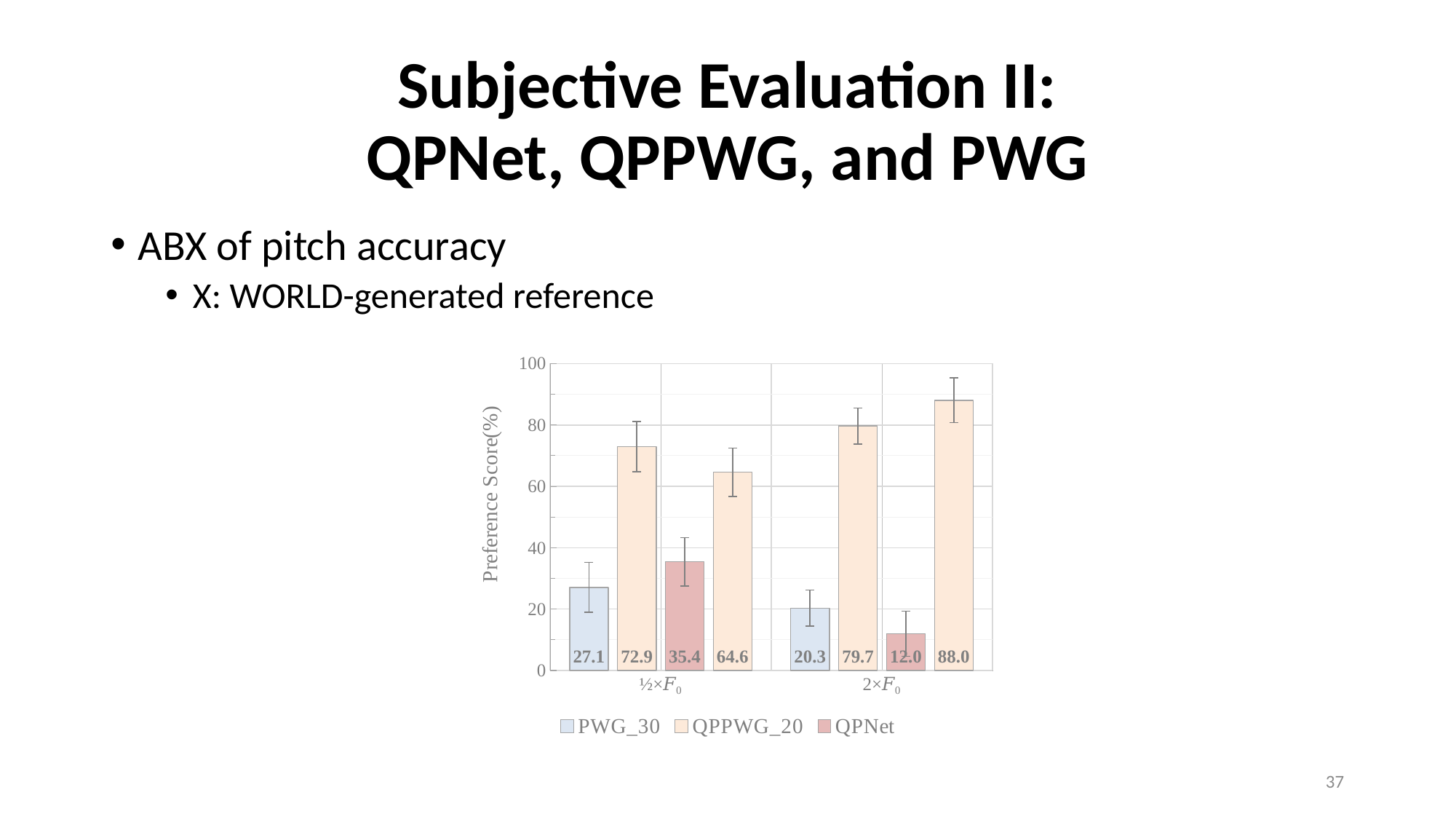
Which is larger: the QPNet score in the ½×F0 group or the QPNet score in the 2×F0 group? ½×F0 (35.4) How many series does the legend list? 3 What is the preference score for PWG_30 in the 2×F0 group? 20.3 Which bar has the highest preference score on the chart? QPPWG_20 (88.0) in the 2×F0 group In the ½×F0 group, what is the difference between the QPPWG_20 score paired with PWG_30 (72.9) and the PWG_30 score? 45.8 What are the two group labels on the x axis? ½×F0 and 2×F0 What is the preference score for QPNet in the ½×F0 group? 35.4 What is the label of the y axis? Preference Score(%) What is the preference score for QPNet in the 2×F0 group? 12.0 Which bar has the lowest preference score on the chart? QPNet (12.0) in the 2×F0 group What kind of chart is shown on the slide? Bar chart What is the preference score for PWG_30 in the ½×F0 group? 27.1